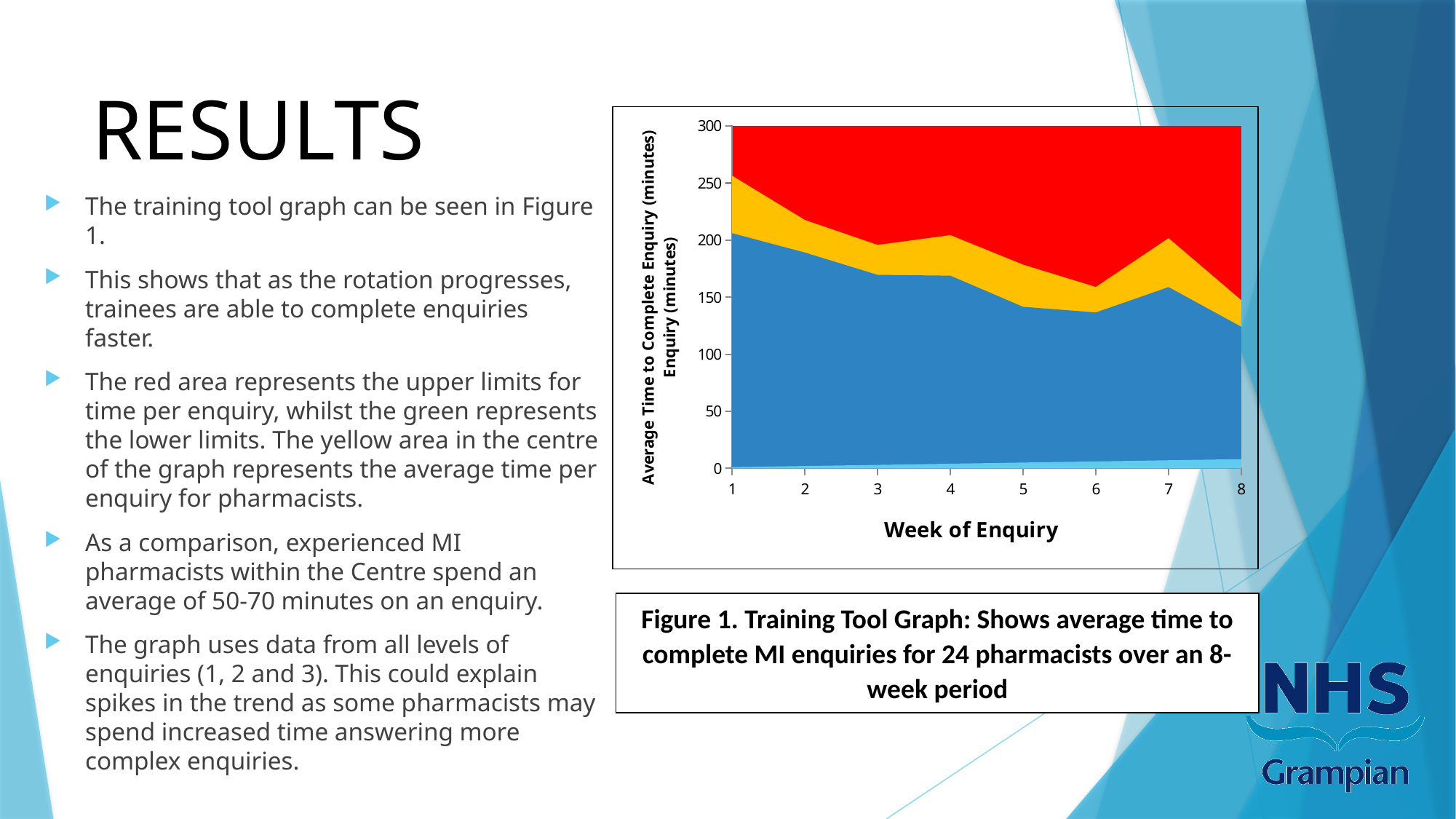
What is the title of the y axis of the chart? Average Time to Complete Enquiry (minutes) Is the top of the blue area at week 1 greater or less than 200? greater How many weeks are plotted along the x axis of the chart? 8 What kind of chart is shown on the slide? Area chart Is the top of the blue area at week 4 greater or less than 150? greater Is the top of the blue area larger at week 1 or at week 8? Week 1 At which week is the top of the blue area highest? Week 1 Does the top of the blue area generally rise or fall from week 1 to week 8? Fall Is the top of the blue area at week 6 greater or less than 150? less What is the title of the x axis of the chart? Week of Enquiry